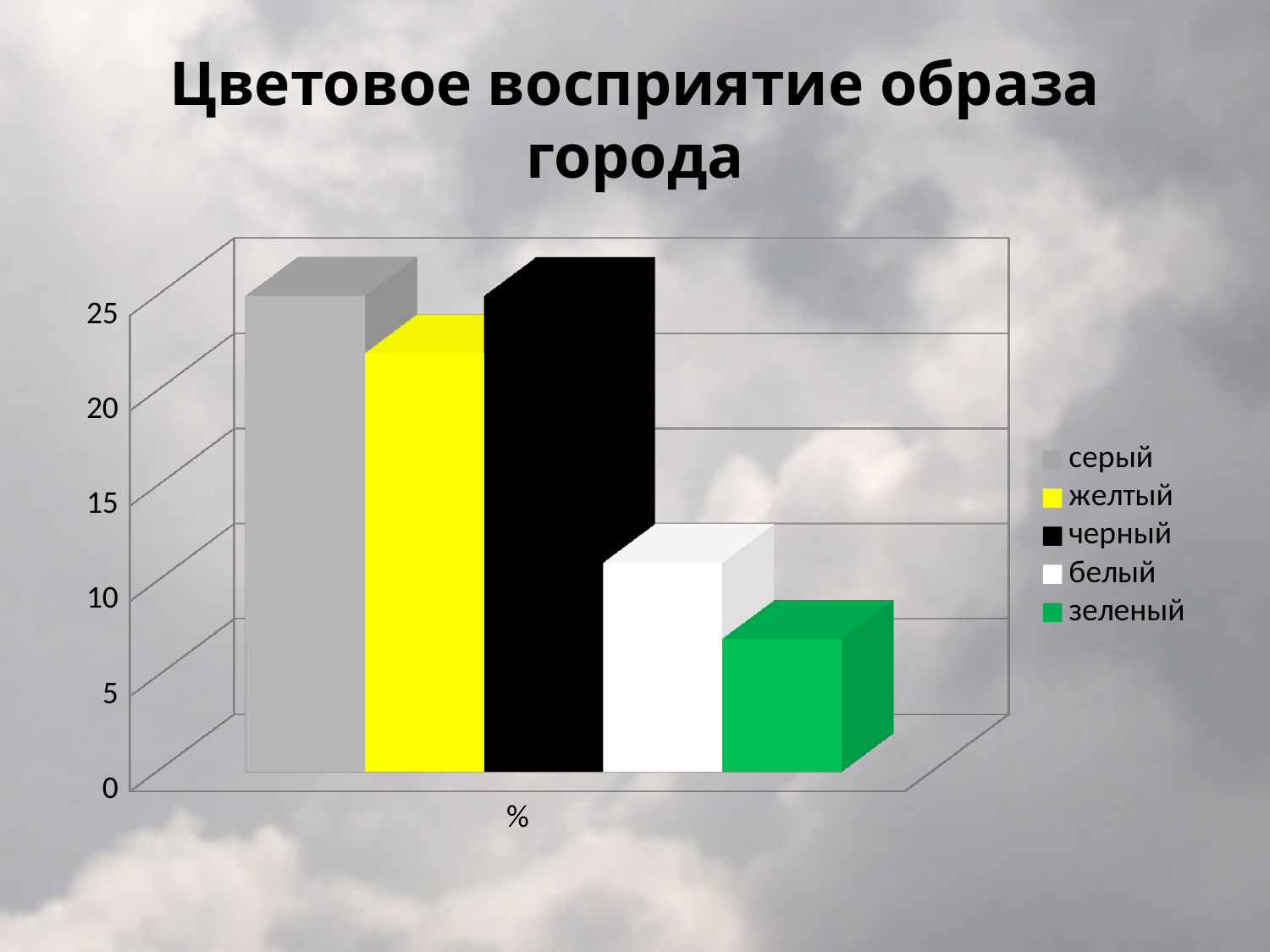
How many bars are plotted in the chart? 5 Which is larger, the value for желтый or the value for белый? желтый What kind of chart is shown on the slide? bar chart Is the value for желтый greater or less than 20? greater Which is larger, the value for белый or the value for зеленый? белый Is the value for зеленый greater or less than 10? less Is the value for белый greater or less than 10? greater How many series does the legend list? 5 Which colour has the lowest value in the chart? зеленый What is the title of the chart? Цветовое восприятие образа города Which is larger, the value for серый or the value for белый? серый What label is shown under the horizontal axis of the chart? %